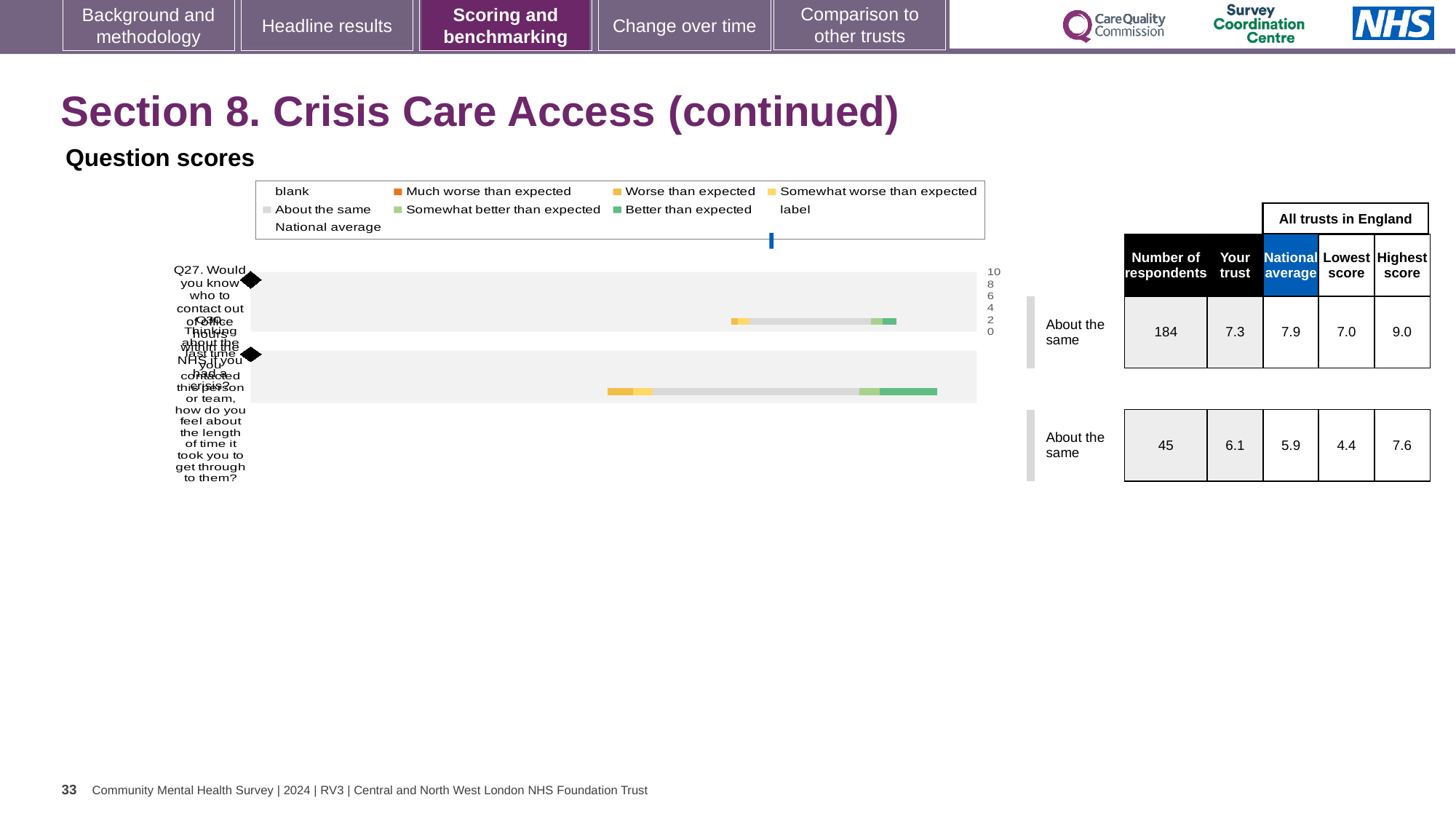
Which question has the higher 'Your trust' score, Q27 or Q30? Q27 For Q27, which is larger: the 'Your trust' score or the national average? National average What is the lowest score among all trusts in England for Q30? 4.4 What is the 'Your trust' score for Q27 (Would you know who to contact out of office hours within the NHS if you had a crisis?)? 7.3 For Q30, what is the difference between the 'Your trust' score and the national average? 0.2 For Q27, what is the difference between the highest score and the lowest score among all trusts in England? 2.0 What benchmark category is shown next to the bar for Q27? About the same What is the highest score among all trusts in England for Q30? 7.6 How many respondents answered Q27? 184 What kind of chart is used to show the question scores on this slide? bar chart How many questions (categories) are plotted in the question scores chart? 2 What is the national average score for Q30 (how do you feel about the length of time it took you to get through to them?)? 5.9